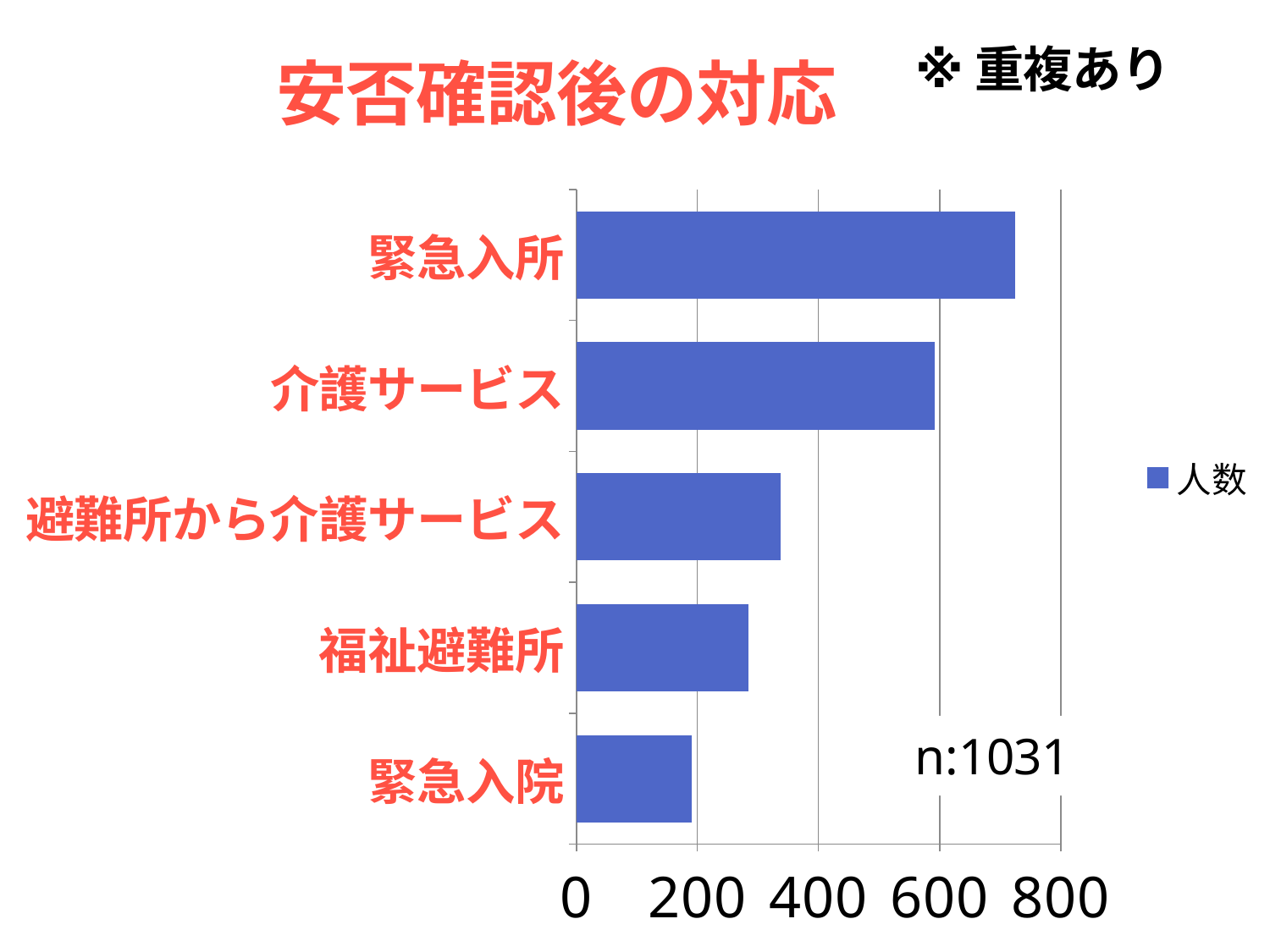
Is the value for 避難所から介護サービス greater or less than 400? less Is the value for 緊急入所 greater or less than 600? greater How many categories are plotted in the chart? 5 Which category has the highest value? 緊急入所 How many series does the legend list? 1 What is the title of the chart? 安否確認後の対応 What kind of chart is shown on the slide? bar chart Is the value for 緊急入院 greater or less than 400? less Which is larger, the value for 避難所から介護サービス or the value for 福祉避難所? 避難所から介護サービス Which category has the lowest value? 緊急入院